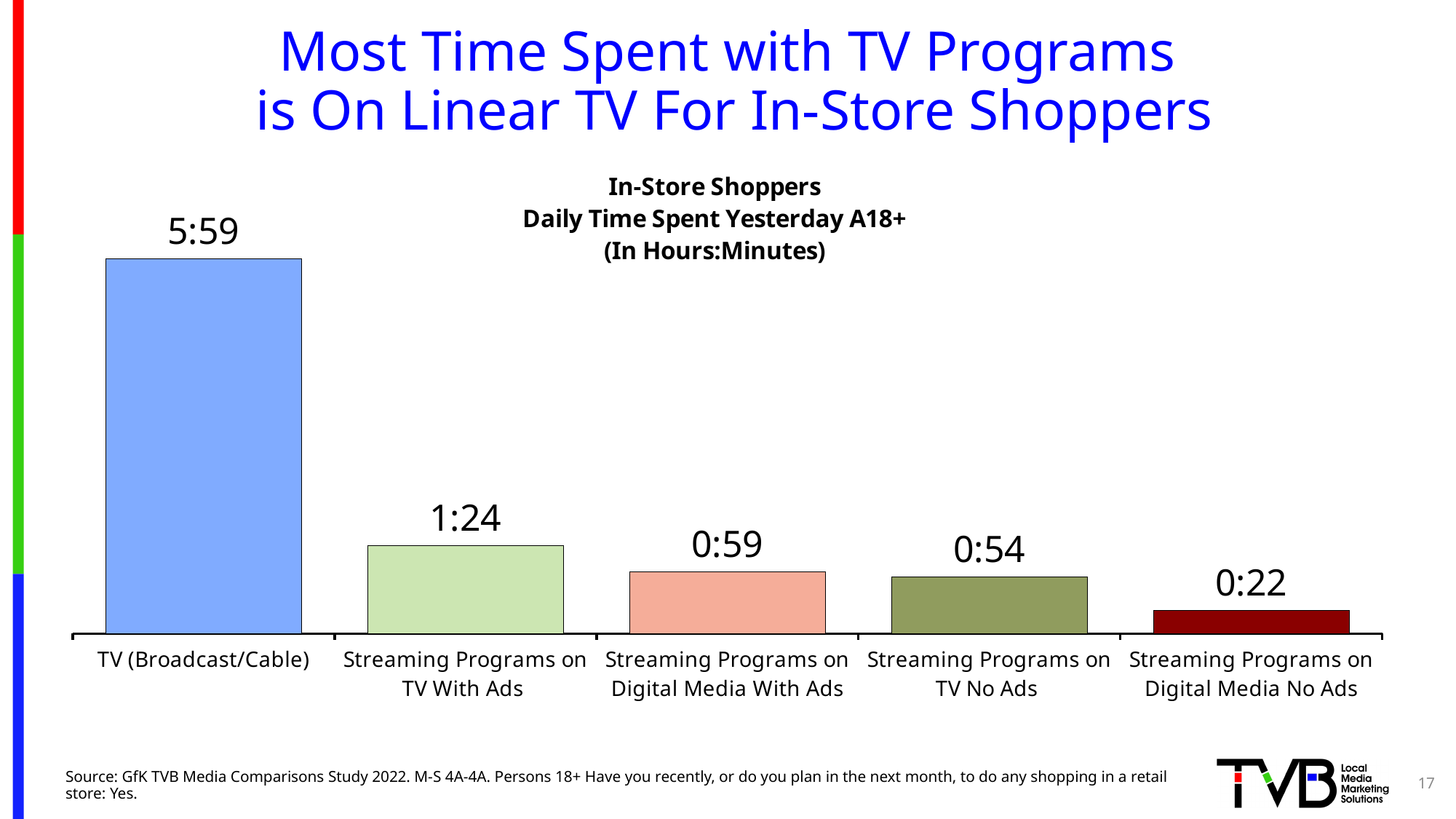
Which category has the highest daily time spent? TV (Broadcast/Cable) Which is larger: the time spent on Streaming Programs on TV With Ads or on Streaming Programs on Digital Media With Ads? Streaming Programs on TV With Ads What is the difference in daily time spent between TV (Broadcast/Cable) and Streaming Programs on TV With Ads? 4:35 Which category has the lowest daily time spent? Streaming Programs on Digital Media No Ads In what units are the values in the chart expressed? Hours:Minutes What is the daily time spent for TV (Broadcast/Cable)? 5:59 What is the daily time spent for Streaming Programs on Digital Media With Ads? 0:59 How many categories are shown in the chart? 5 What kind of chart is shown on the slide? Bar chart What is the daily time spent for Streaming Programs on TV No Ads? 0:54 What is the daily time spent for Streaming Programs on Digital Media No Ads? 0:22 What is the daily time spent for Streaming Programs on TV With Ads? 1:24